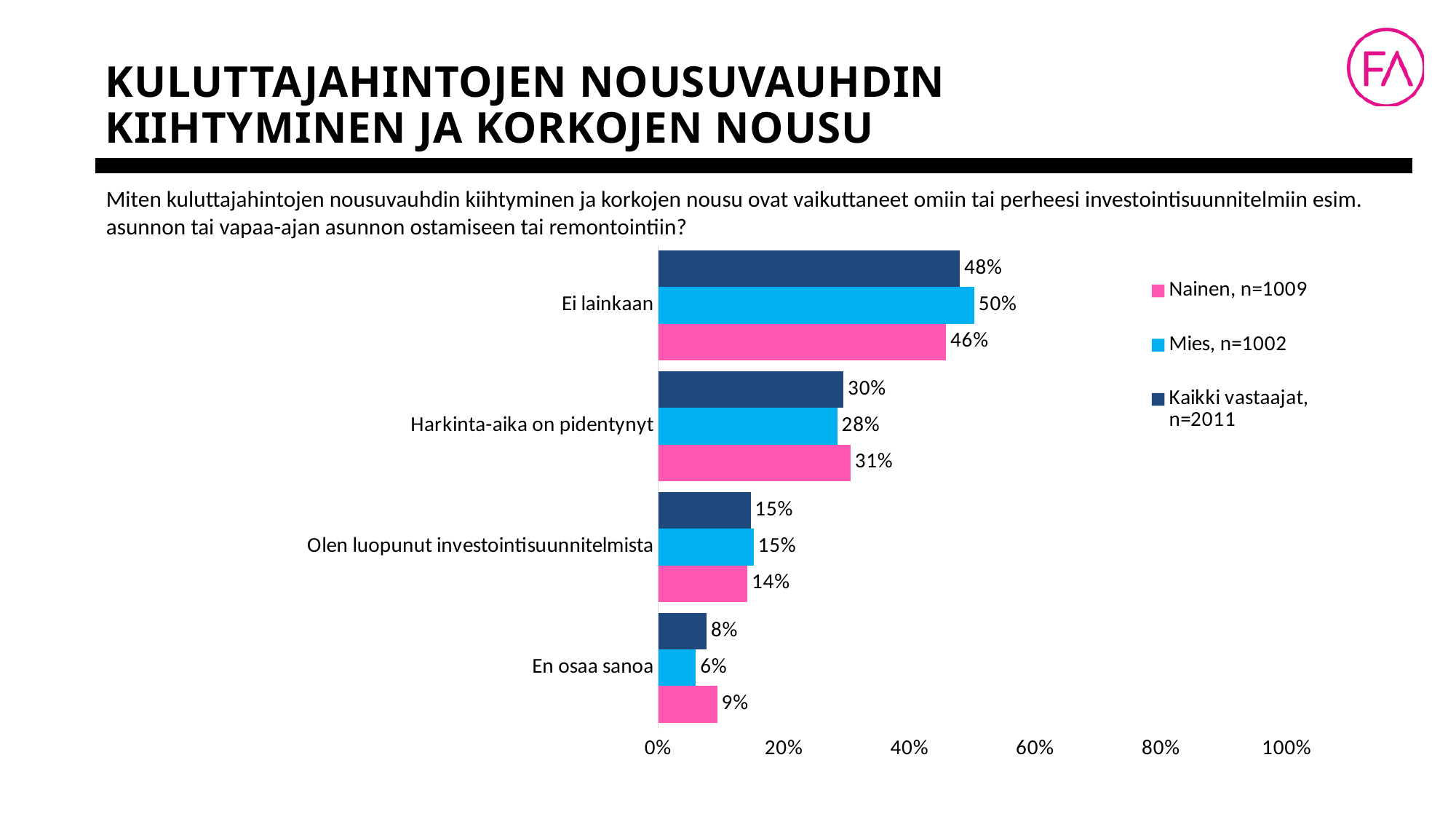
Which category has the lowest value for "Mies, n=1002"? En osaa sanoa What is the value for "Nainen, n=1009" in the "Harkinta-aika on pidentynyt" category? 31% In the "Harkinta-aika on pidentynyt" category, which is larger: the value for "Nainen, n=1009" or for "Mies, n=1002"? Nainen, n=1009 Which category has the highest value for "Kaikki vastaajat, n=2011"? Ei lainkaan Which colour represents the "Nainen, n=1009" series? Pink What kind of chart is shown on the slide? Bar chart Is the value for "Kaikki vastaajat, n=2011" in the "Ei lainkaan" category greater or less than 40%? greater What is the value for "Mies, n=1002" in the "Ei lainkaan" category? 50% How many categories are shown on the chart? 4 How many series does the legend list? 3 What is the difference between the "Mies, n=1002" and "Nainen, n=1009" values in the "Ei lainkaan" category? 4% What is the value for "Kaikki vastaajat, n=2011" in the "En osaa sanoa" category? 8%